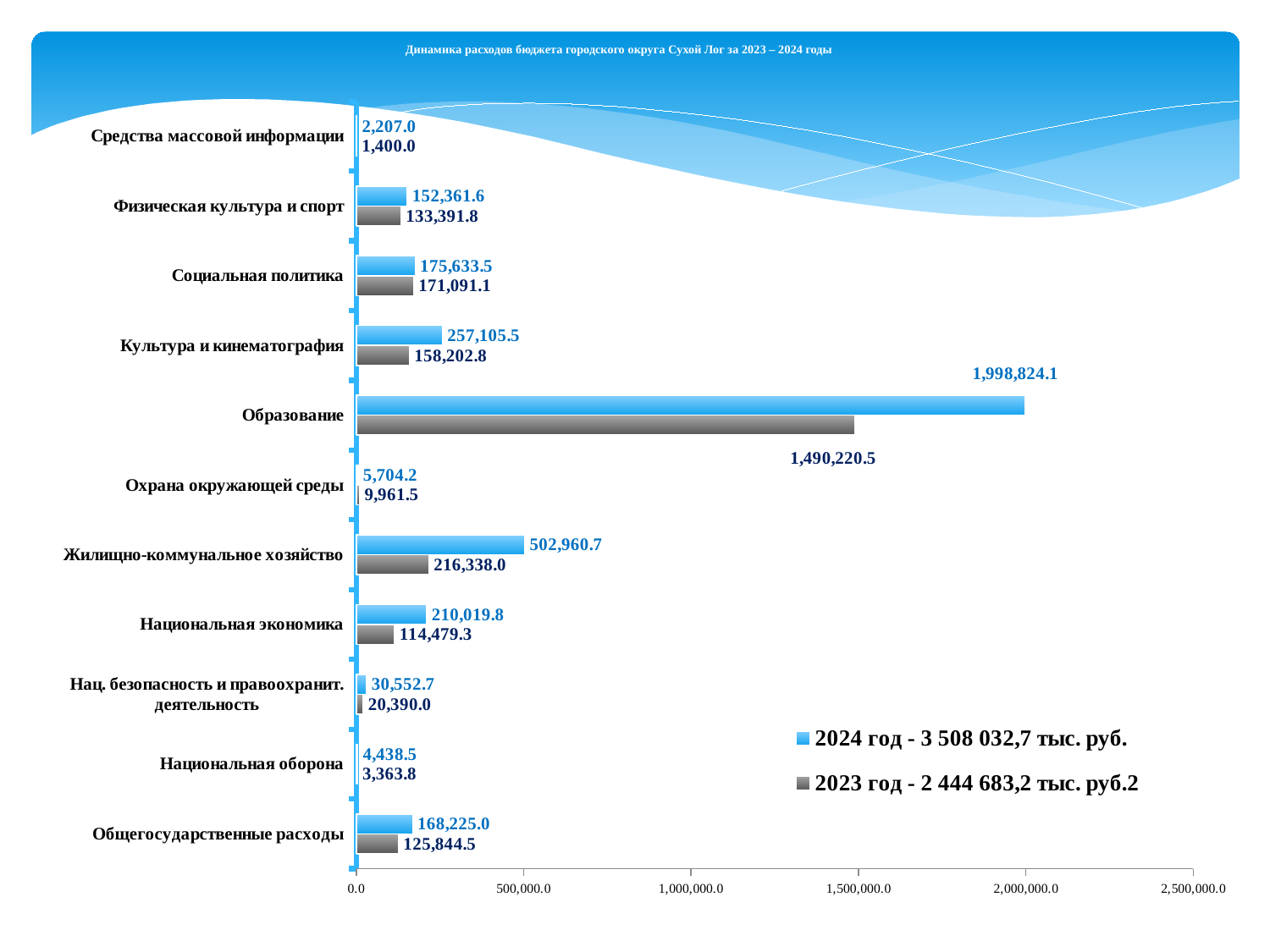
Is the 2024 value for Образование greater or less than 1,500,000.0? greater What is the difference between the 2024 and 2023 values for Образование? 508,603.6 What is the difference between the 2024 and 2023 values for Жилищно-коммунальное хозяйство? 286,622.7 What is the 2023 value for Жилищно-коммунальное хозяйство? 216,338.0 Which category has the lowest 2023 value? Средства массовой информации What is the 2024 value for Национальная оборона? 4,438.5 How many series does the legend list? 2 Which category has the highest 2024 value? Образование How many categories are shown on the chart? 11 Which is larger for Охрана окружающей среды, the 2024 value or the 2023 value? 2023 What is the 2024 value for Образование? 1,998,824.1 What kind of chart is shown on the slide? Bar chart